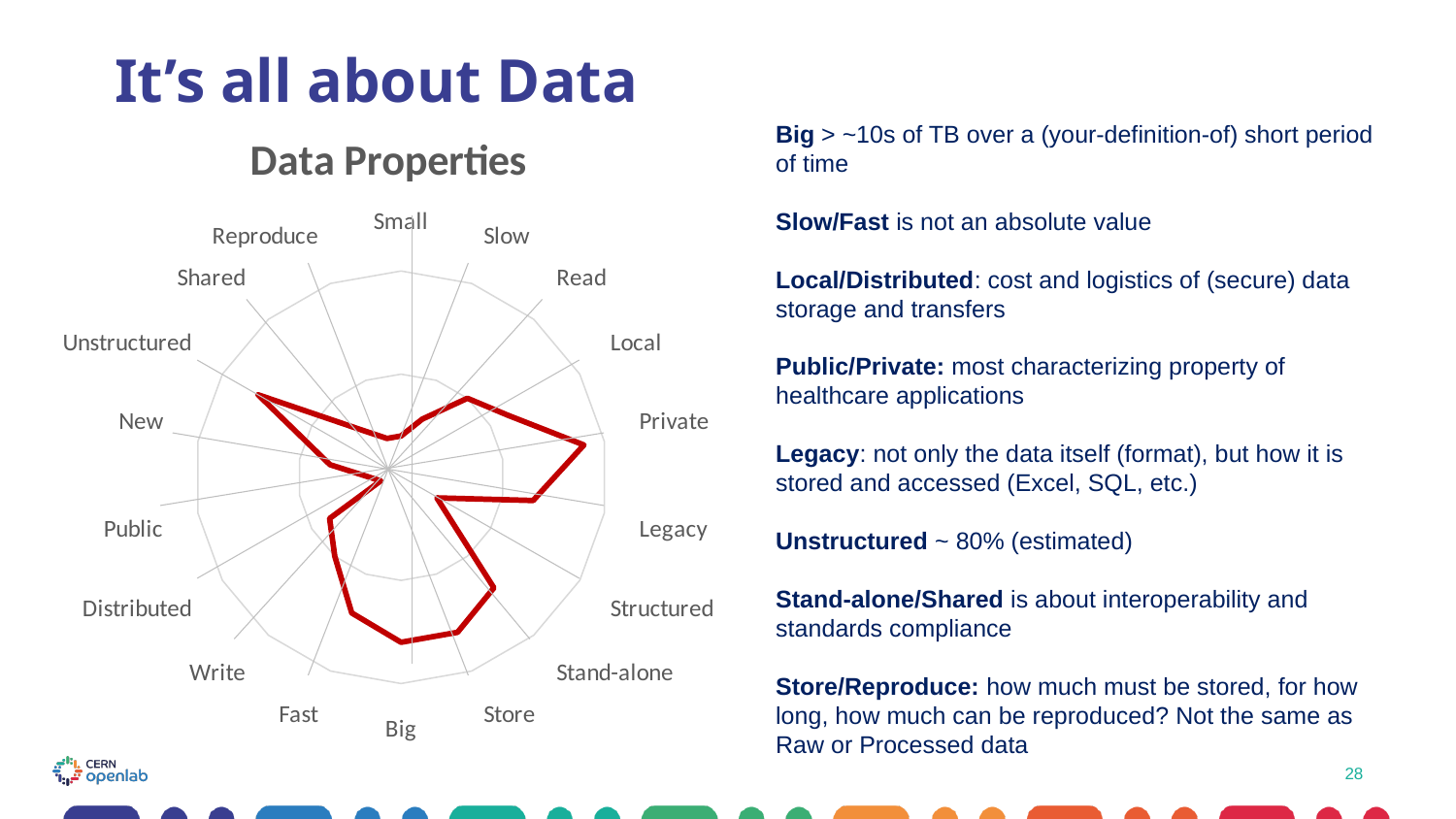
Which has the larger value, Fast or Slow? Fast Which category has the highest value in the radar chart? Private What kind of chart is shown on the slide? Radar chart Which has the larger value, Unstructured or Shared? Unstructured Which has the larger value, Write or Reproduce? Write How many categories (axes) does the radar chart have? 18 What colour is the data line plotted on the radar chart? Red What is the title of the chart? Data Properties